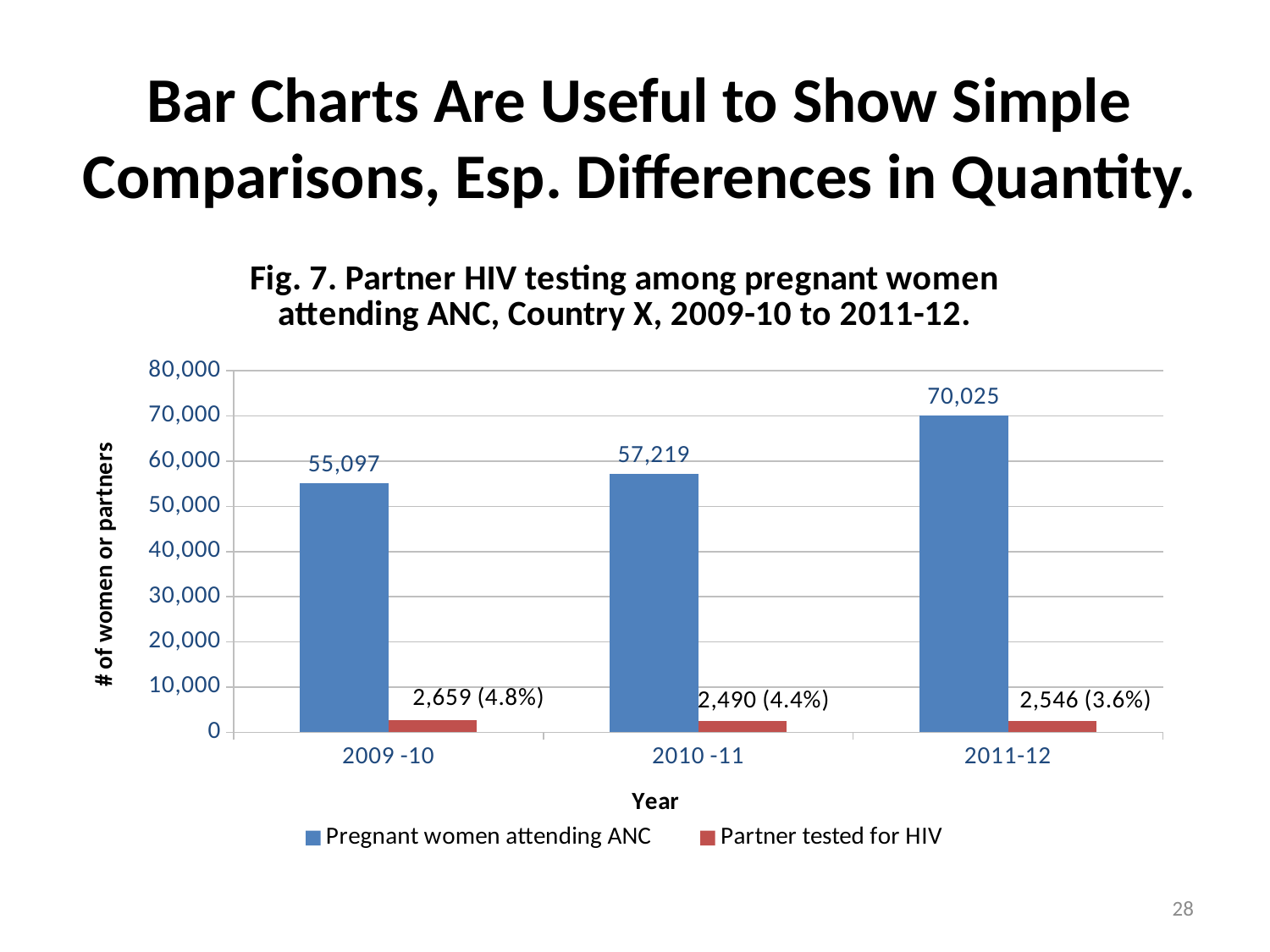
What is the data label for Partner tested for HIV in 2009 -10? 2,659 (4.8%) Which year has the lowest number of Pregnant women attending ANC? 2009 -10 How many years are shown on the x axis? 3 What is the value for Pregnant women attending ANC in 2011-12? 70,025 What is the difference in Pregnant women attending ANC between 2011-12 and 2009 -10? 14,928 How many series does the legend list? 2 Which year has the highest number of Pregnant women attending ANC? 2011-12 Is the value for Pregnant women attending ANC in 2011-12 greater or less than 60,000? greater What is the value for Pregnant women attending ANC in 2010 -11? 57,219 What kind of chart is shown? bar chart Which is larger: Partner tested for HIV in 2009 -10 or in 2010 -11? 2009 -10 Does the number of Pregnant women attending ANC rise or fall from 2009 -10 to 2011-12? rise